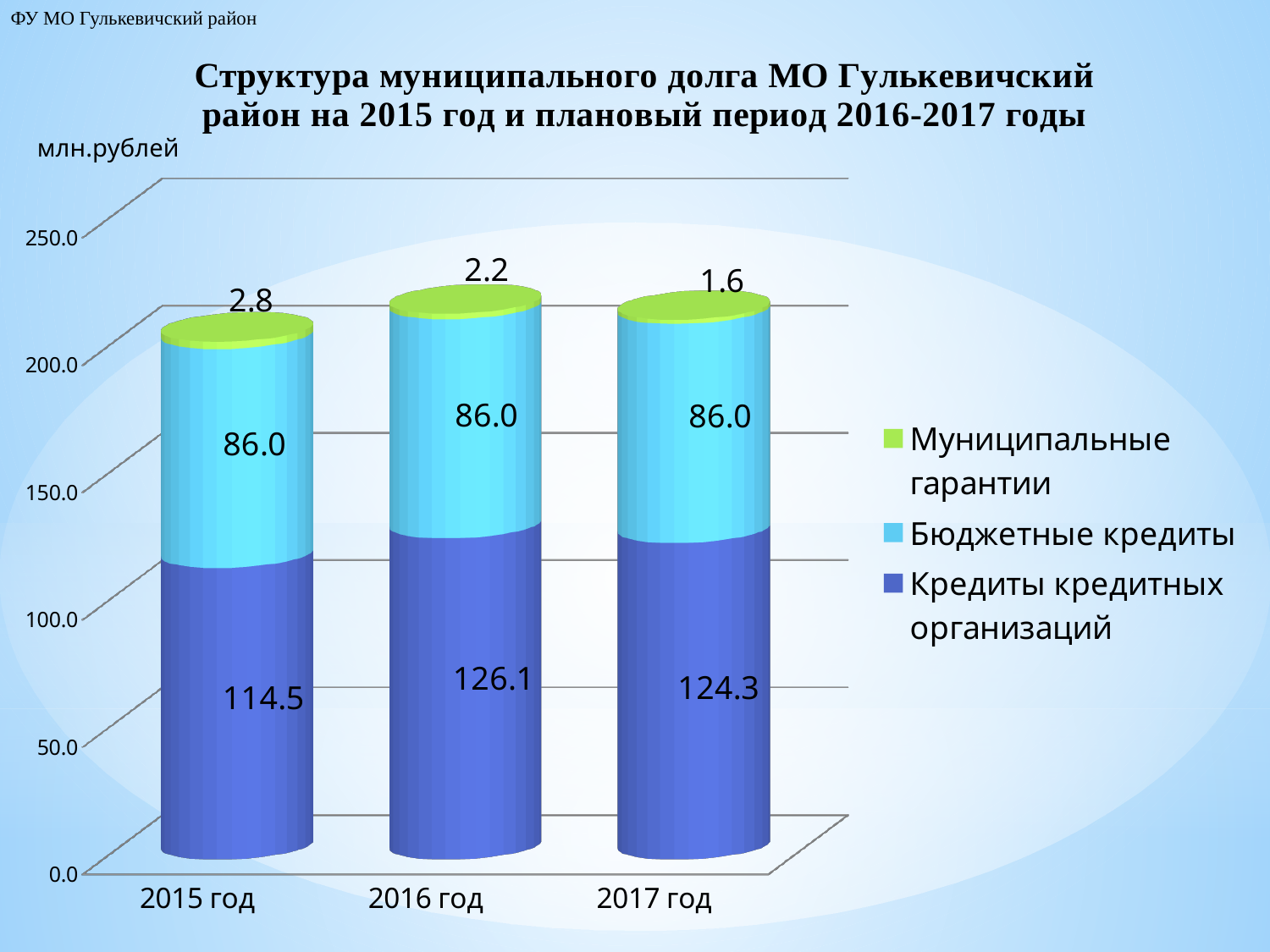
What is the value of Бюджетные кредиты for 2016 год? 86.0 What kind of chart is shown on the slide? Stacked bar chart What is the difference between Кредиты кредитных организаций in 2016 год and 2015 год? 11.6 In which year is the value of Муниципальные гарантии lowest? 2017 год What is the value of Кредиты кредитных организаций for 2015 год? 114.5 In which year is the value of Кредиты кредитных организаций highest? 2016 год What is the total of the stacked bar for 2015 год? 203.3 How many years are shown on the x axis? 3 Which is larger: Муниципальные гарантии in 2015 год or in 2016 год? 2015 год What is the total of the stacked bar for 2016 год? 214.3 How many series does the legend list? 3 What is the value of Муниципальные гарантии for 2017 год? 1.6